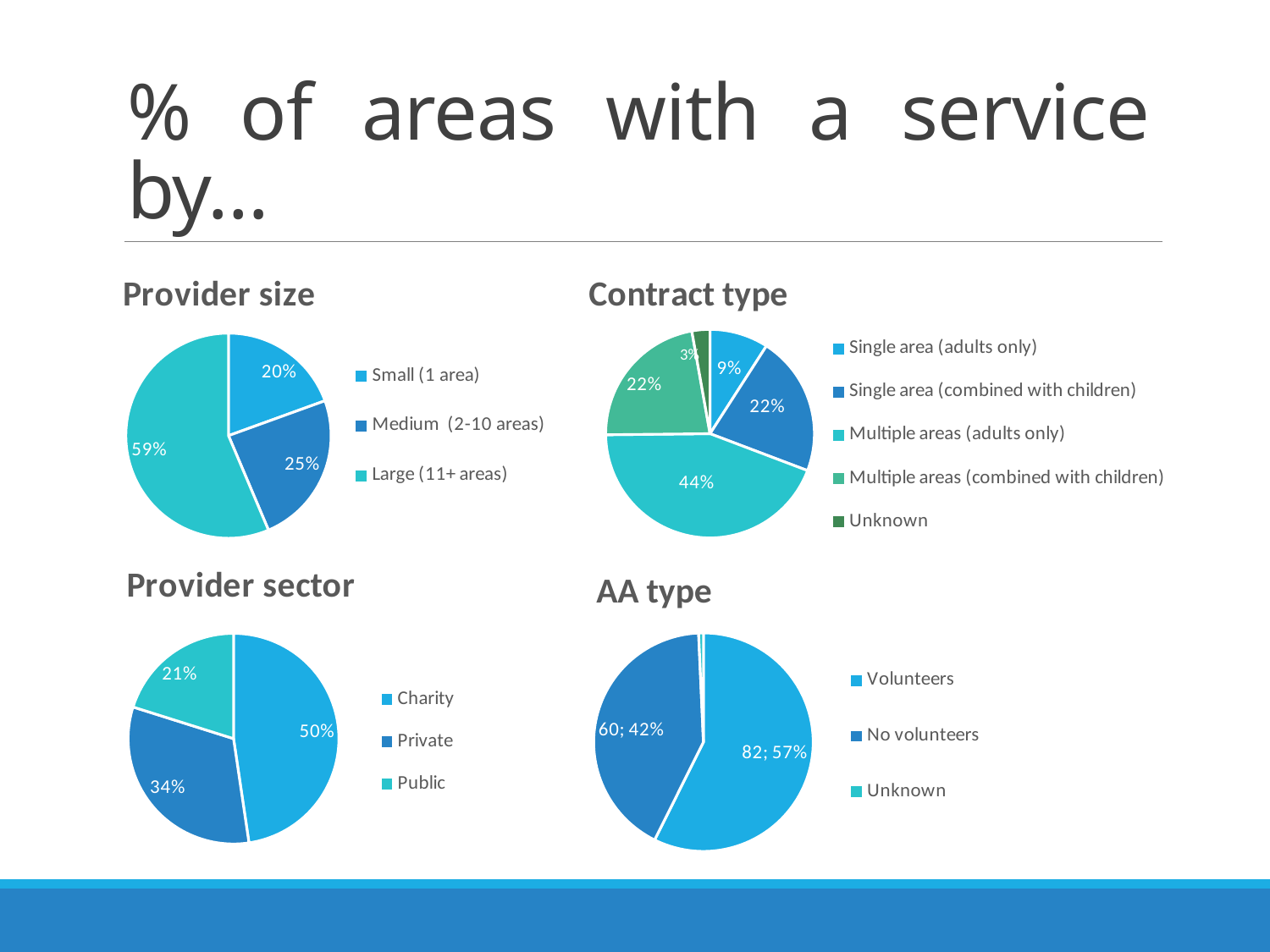
What type of chart is the AA type chart? Pie chart In the Contract type chart, which contract type has the smallest share? Unknown In the Provider size chart, which provider size has the smallest share? Small (1 area) In the Provider sector chart, which is larger, the Charity share or the Public share? Charity In the Provider sector chart, what share of areas have a Private provider? 34% In the Contract type chart, what share is Multiple areas (adults only)? 44% In the AA type chart, what is the value shown for No volunteers? 60; 42% In the Contract type chart, which contract type has the largest share? Multiple areas (adults only) In the AA type chart, which category has the largest share? Volunteers In the Provider size chart, what is the difference between the Medium (2-10 areas) and Small (1 area) shares? 5% How many entries does the legend of the Contract type chart list? 5 In the Provider size chart, what share of areas have a Large (11+ areas) provider? 59%